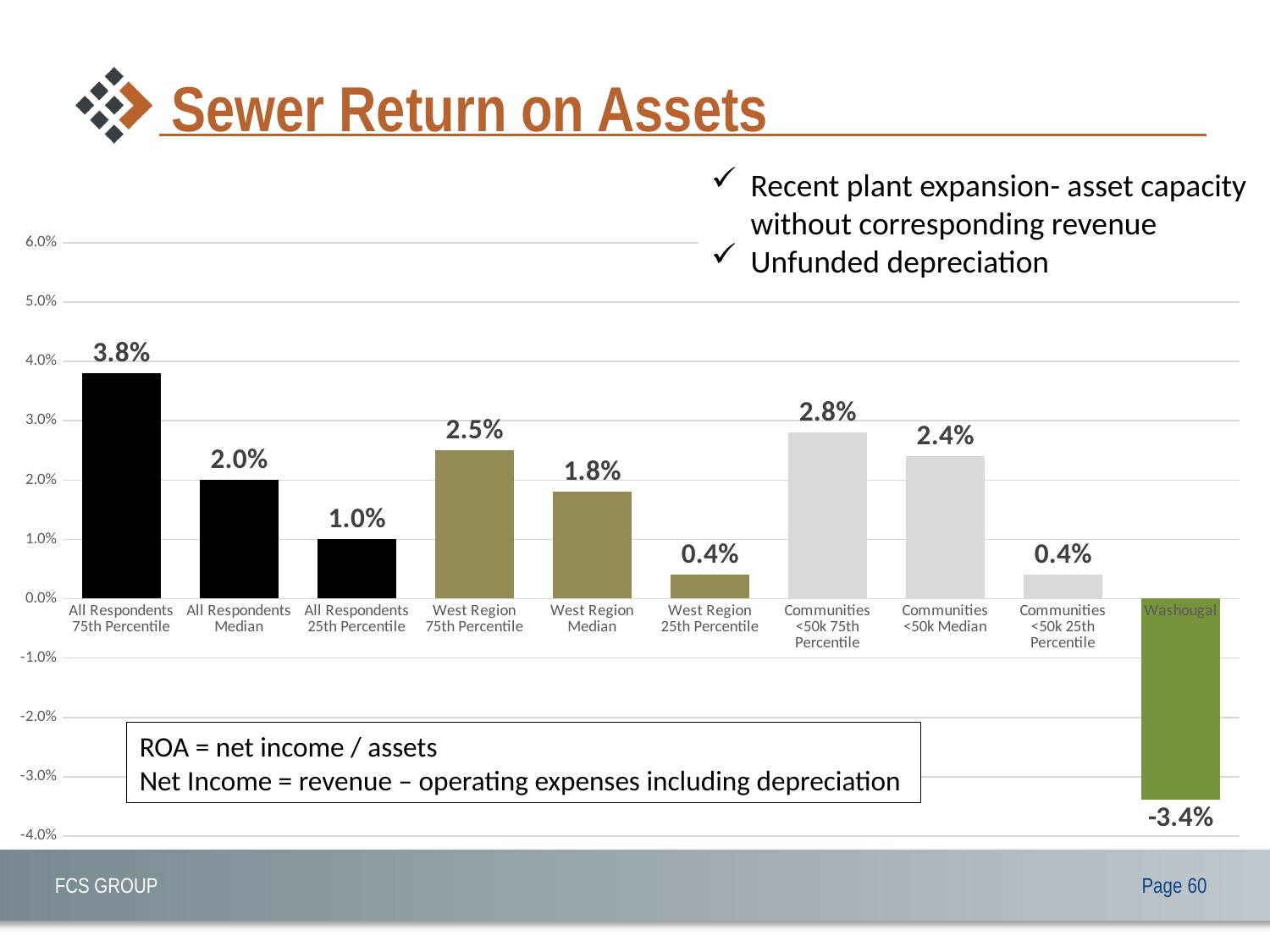
Which category has the highest value on the chart? All Respondents 75th Percentile What is the value for West Region Median? 1.8% What is the difference between the All Respondents 75th Percentile value and the All Respondents Median value? 1.8% How many categories are plotted on the chart? 10 What kind of chart is shown on the slide? Bar chart Which is larger, the West Region 75th Percentile value or the Communities <50k 75th Percentile value? Communities <50k 75th Percentile What is the title of the slide containing the chart? Sewer Return on Assets What is the Sewer Return on Assets value for All Respondents 75th Percentile? 3.8% What is the difference between the Communities <50k Median value and the West Region Median value? 0.6% Which category has the lowest value on the chart? Washougal What is the value for Communities <50k 75th Percentile? 2.8% What is the value shown for Washougal? -3.4%